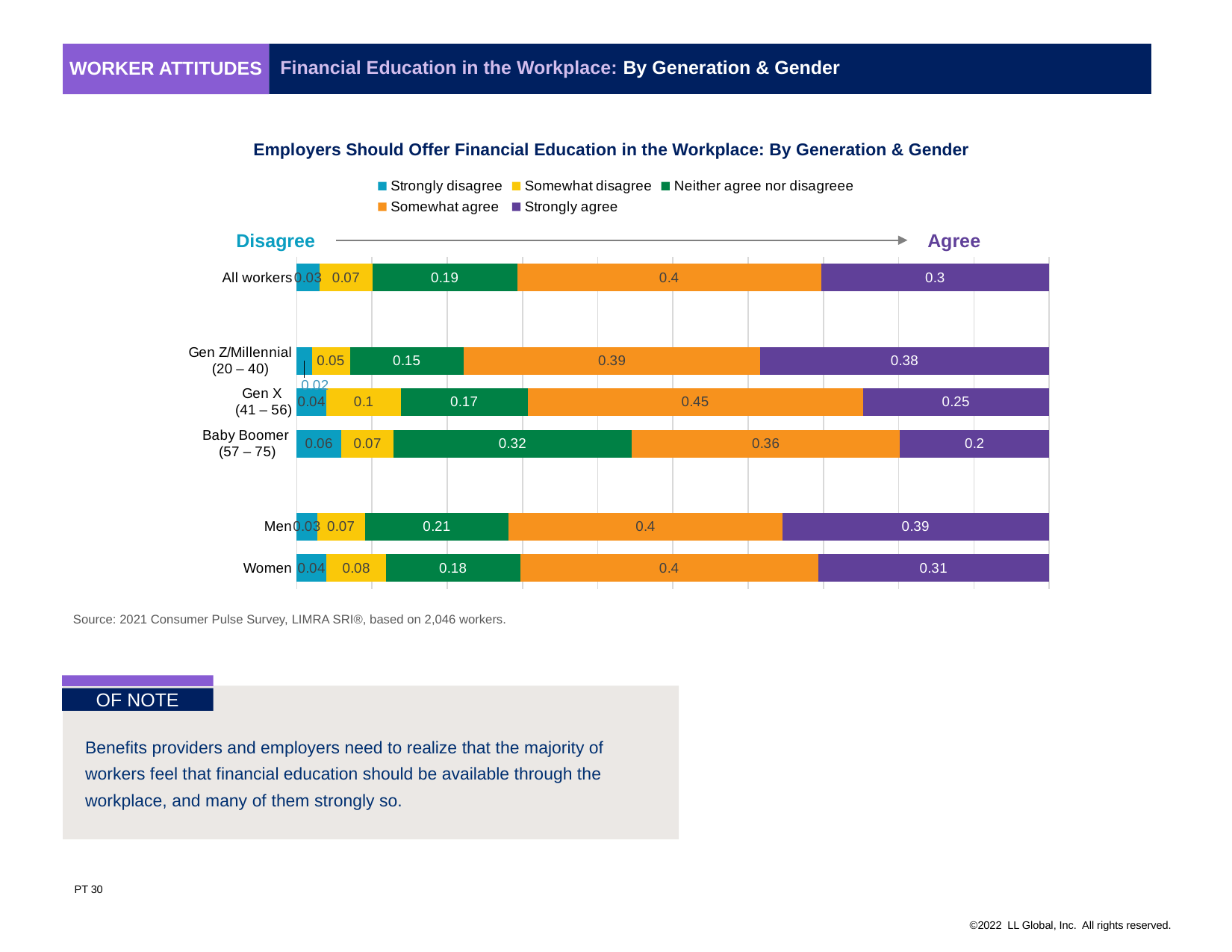
What is the Strongly disagree value for Baby Boomer (57 – 75)? 0.06 Which category has the highest Neither agree nor disagree value? Baby Boomer (57 – 75) Which category has the highest Somewhat agree value? Gen X (41 – 56) Which has the larger Neither agree nor disagree value, Men or Women? Men Which category has the lowest Strongly agree value? Baby Boomer (57 – 75) What kind of chart is shown on the slide? Stacked bar chart What is the Neither agree nor disagree value for Baby Boomer (57 – 75)? 0.32 How many categories are shown on the chart? 6 What is the difference between the Strongly agree values for Gen Z/Millennial (20 – 40) and Gen X (41 – 56)? 0.13 What is the Somewhat agree value for Gen X (41 – 56)? 0.45 How many series does the legend list? 5 What is the Strongly agree value for Gen Z/Millennial (20 – 40)? 0.38